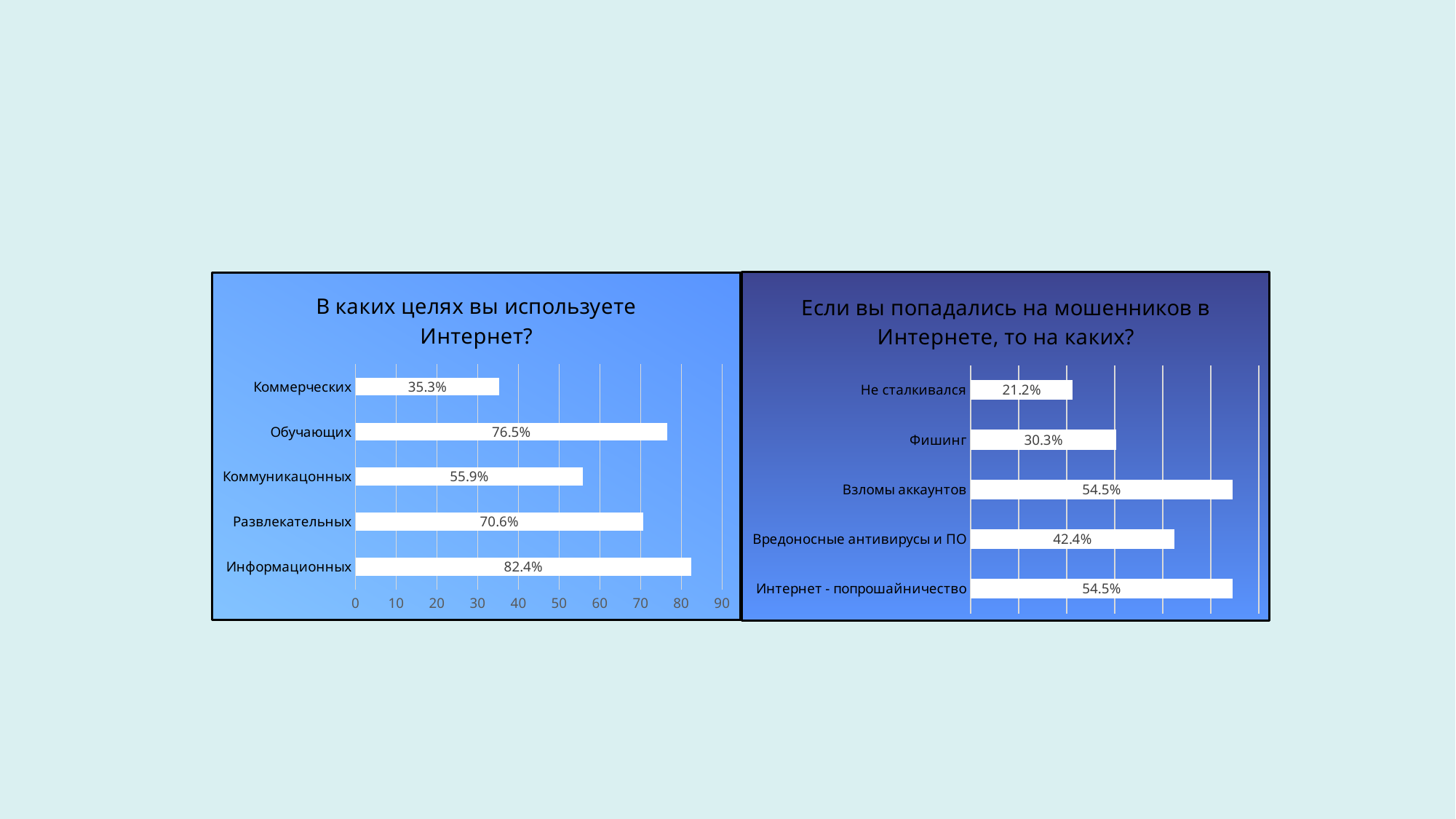
In the chart titled "Если вы попадались на мошенников в Интернете, то на каких?", what is the value for Фишинг? 30.3% What kind of chart is the chart on the right of the slide? Bar chart In the chart titled "Если вы попадались на мошенников в Интернете, то на каких?", what is the difference between the values for Взломы аккаунтов and Фишинг? 24.2% In the chart titled "Если вы попадались на мошенников в Интернете, то на каких?", what is the value for Вредоносные антивирусы и ПО? 42.4% In the chart titled "В каких целях вы используете Интернет?", what is the difference between the values for Информационных and Коммерческих? 47.1% In the chart titled "В каких целях вы используете Интернет?", what is the value for Обучающих? 76.5% In the chart titled "В каких целях вы используете Интернет?", what is the highest tick value shown on the horizontal axis? 90 In the chart titled "В каких целях вы используете Интернет?", which category has the lowest value? Коммерческих In the chart titled "Если вы попадались на мошенников в Интернете, то на каких?", which category has the lowest value? Не сталкивался In the chart titled "В каких целях вы используете Интернет?", how many categories are shown? 5 In the chart titled "В каких целях вы используете Интернет?", which is larger: Развлекательных or Коммуникацонных? Развлекательных In the chart titled "В каких целях вы используете Интернет?", which category has the highest value? Информационных